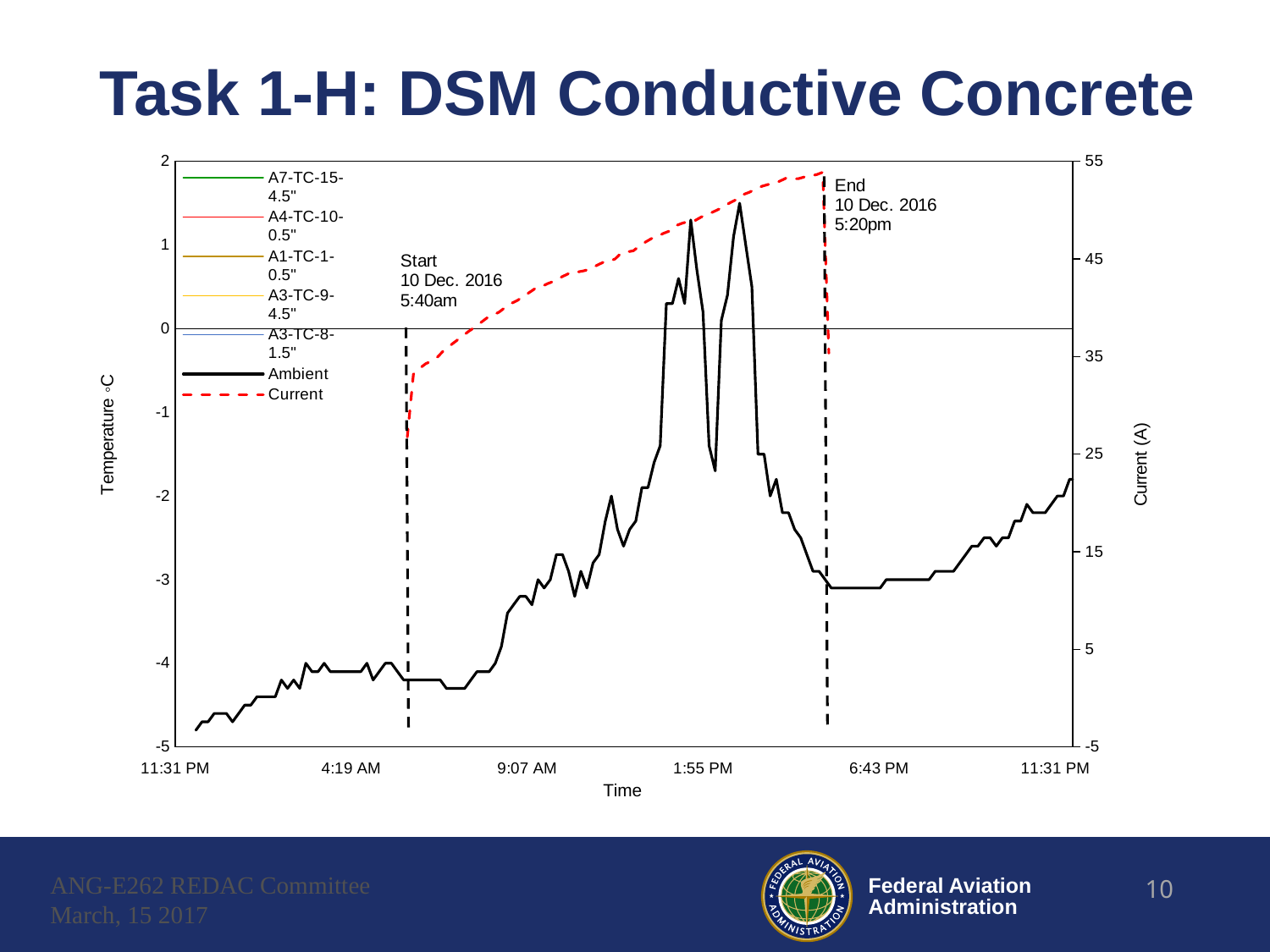
What date and time does the 'Start' annotation on the chart give? 10 Dec. 2016 5:40am What is the lowest tick value shown on the left-hand Temperature axis? -5 What is the label of the right-hand vertical axis? Current (A) How many series does the legend list? 7 How many time labels are shown along the x axis? 6 What kind of chart is shown on the slide? line chart What is the highest tick value shown on the right-hand Current (A) axis? 55 What is the title of the slide containing the chart? Task 1-H: DSM Conductive Concrete Is the Ambient temperature at 11:31 PM (left end of the x axis) greater or less than -4? less Is the Current value at the 'End' marker greater or less than 45? greater Does the Current series rise or fall between the Start and End markers? rise